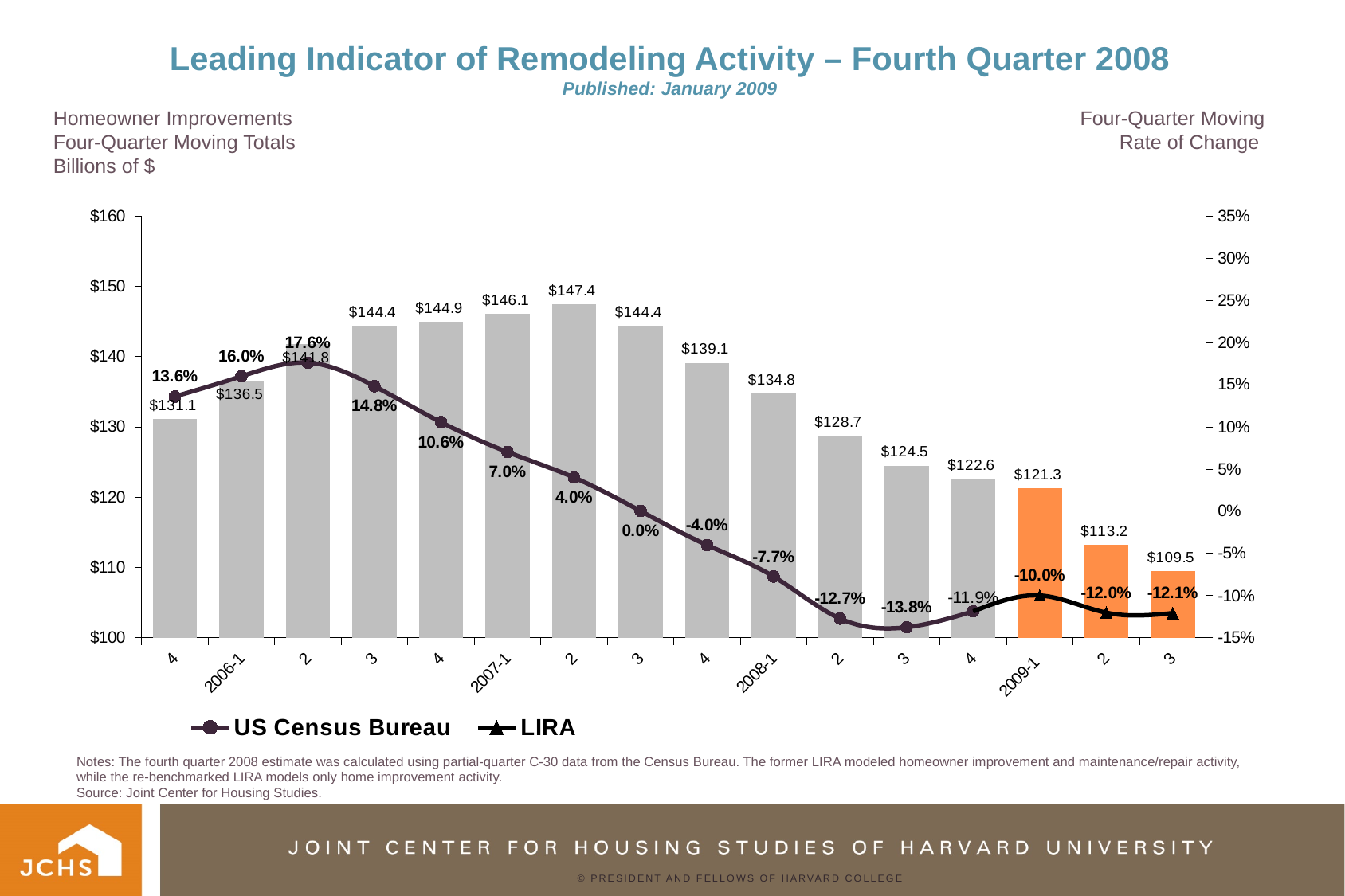
What is the four-quarter moving rate of change shown for 2008-1? -7.7% Which quarter has the highest bar for homeowner improvements four-quarter moving totals? 2007-2 ($147.4) What is the four-quarter moving total of homeowner improvements for the second quarter of 2007 (the bar labeled 2 after 2007-1)? $147.4 What is the difference between the highest bar ($147.4 in 2007-2) and the lowest bar ($109.5 in 2009-3)? $37.9 How many series does the legend list? 2 Do the homeowner improvement four-quarter moving totals rise or fall from 2007-2 through 2009-3? Fall Which is larger, the four-quarter moving total for 2008-4 or for 2009-1? 2008-4 ($122.6) How many quarterly bars are plotted on the chart? 16 Which quarter has the lowest bar for homeowner improvements four-quarter moving totals? 2009-3 ($109.5) What is the lowest four-quarter moving rate of change shown on the line? -13.8% (2008-3) What kind of chart is shown on the slide? A bar chart combined with a line chart What is the highest four-quarter moving rate of change shown on the line, and in which quarter does it occur? 17.6% in 2006-2